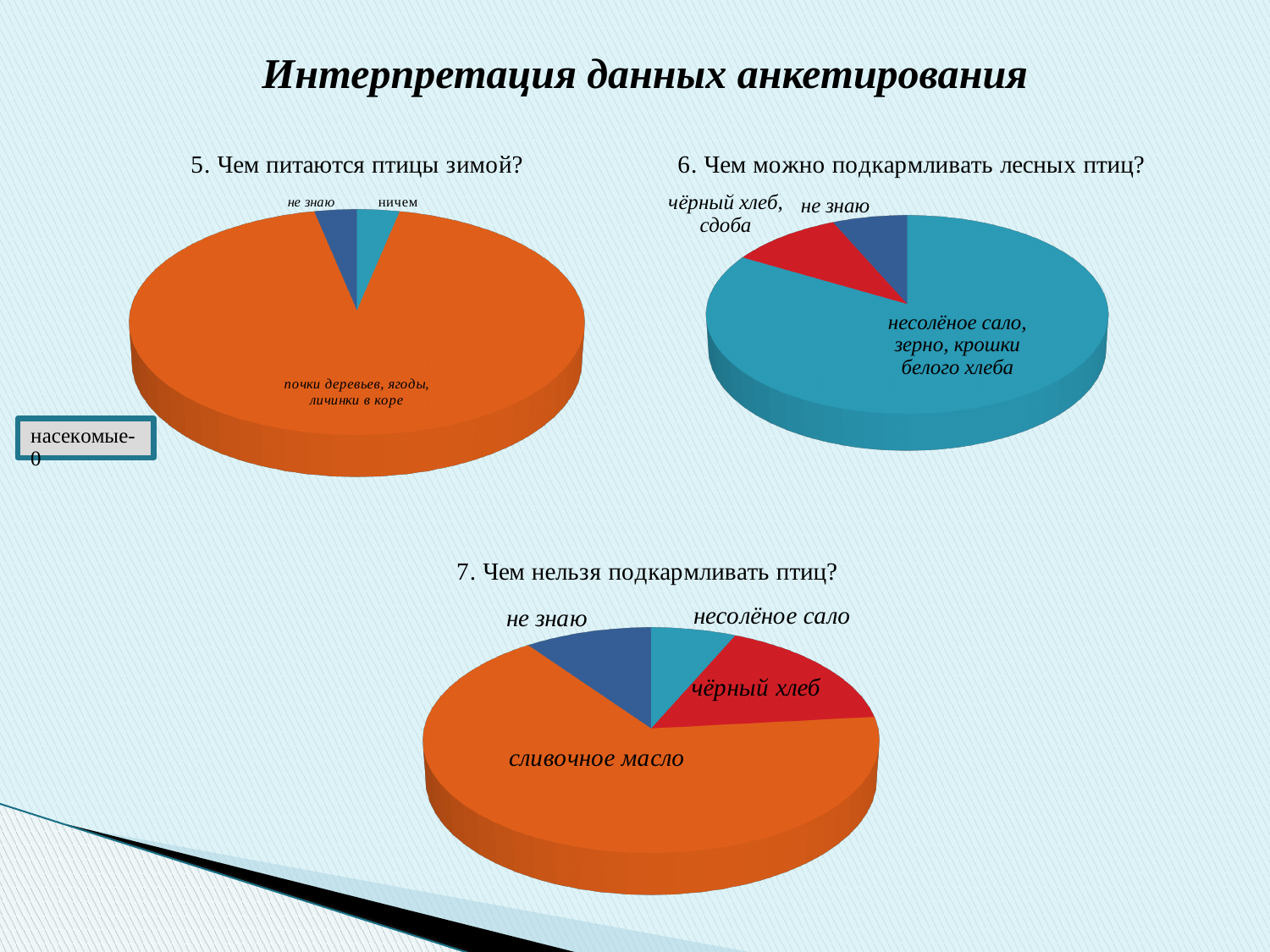
In the chart "7. Чем нельзя подкармливать птиц?", which slice is larger: "чёрный хлеб" or "не знаю"? чёрный хлеб In the chart "7. Чем нельзя подкармливать птиц?", which category has the smallest slice? несолёное сало How many slices does the chart "5. Чем питаются птицы зимой?" have? 3 In the chart "6. Чем можно подкармливать лесных птиц?", which category has the smallest slice? не знаю In the chart "6. Чем можно подкармливать лесных птиц?", which slice is larger: "чёрный хлеб, сдоба" or "не знаю"? чёрный хлеб, сдоба What kind of chart is used for question 5 "Чем питаются птицы зимой?"? pie chart How many slices does the chart "7. Чем нельзя подкармливать птиц?" have? 4 In the chart "6. Чем можно подкармливать лесных птиц?", which category has the largest slice? несолёное сало, зерно, крошки белого хлеба In the chart "7. Чем нельзя подкармливать птиц?", what colour is the "сливочное масло" slice? orange In the chart "5. Чем питаются птицы зимой?", which category has the largest slice? почки деревьев, ягоды, личинки в коре How many pie charts are shown on the slide? 3 In the chart "7. Чем нельзя подкармливать птиц?", which category has the largest slice? сливочное масло